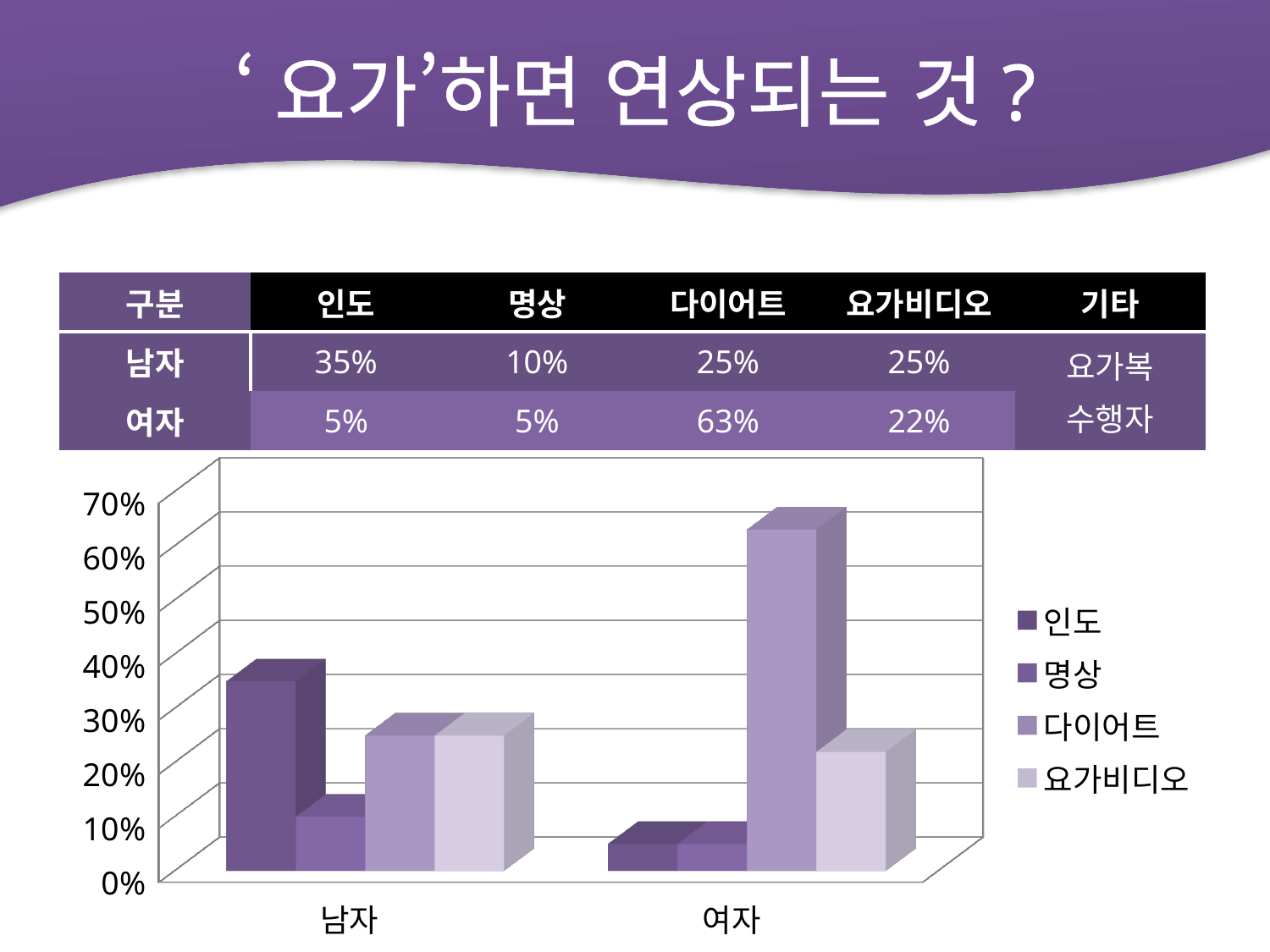
Which legend entry is shown in the lightest shade of purple? 요가비디오 How many categories are shown on the x axis of the chart? 2 Which is larger: 인도 for 남자 or 인도 for 여자? 인도 for 남자 What is the value for 인도 in the 남자 category? 35% Which series has the lowest value in the 남자 category? 명상 Which series has the highest value in the 여자 category? 다이어트 What is the value for 다이어트 in the 여자 category? 63% Is the value for 다이어트 in the 여자 category greater or less than 60%? greater What is the value for 요가비디오 in the 여자 category? 22% What type of chart is shown on the slide? bar chart What is the difference between the 다이어트 values for 여자 and 남자? 38% How many series does the chart legend list? 4